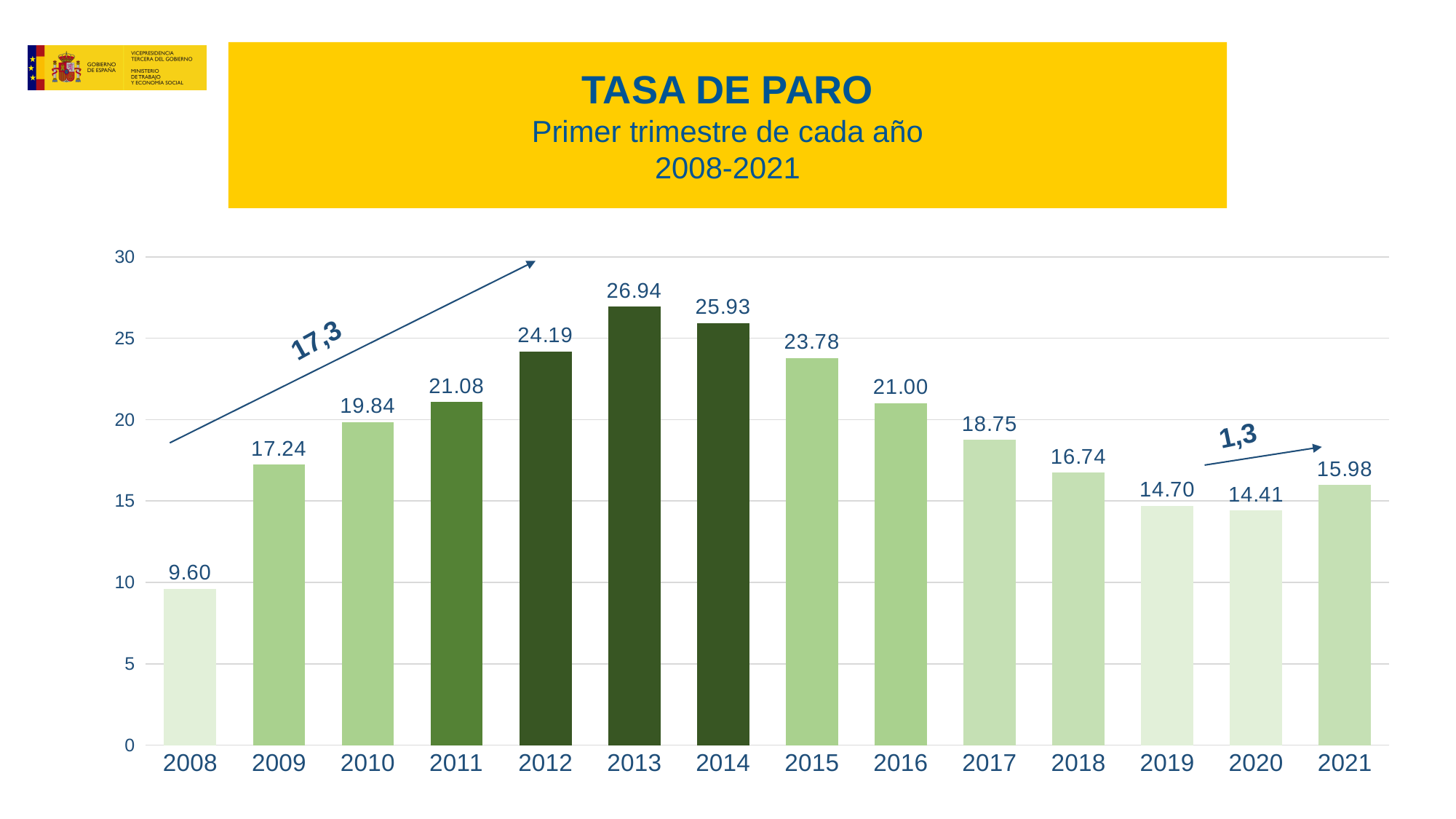
Do the values rise or fall from 2014 to 2020? fall Is the value for 2017 greater or less than 20? less Which year has the lowest value? 2008 What is the difference between the values for 2021 and 2020? 1.57 What kind of chart is shown on the slide? bar chart Which year has the highest value? 2013 What value is shown for 2021? 15.98 Which is larger, the value for 2015 or the value for 2016? 2015 How many years are shown on the x axis? 14 What is the unemployment rate (tasa de paro) shown for 2013? 26.94 What value is shown for 2008? 9.60 What is the difference between the values for 2013 and 2008? 17.34